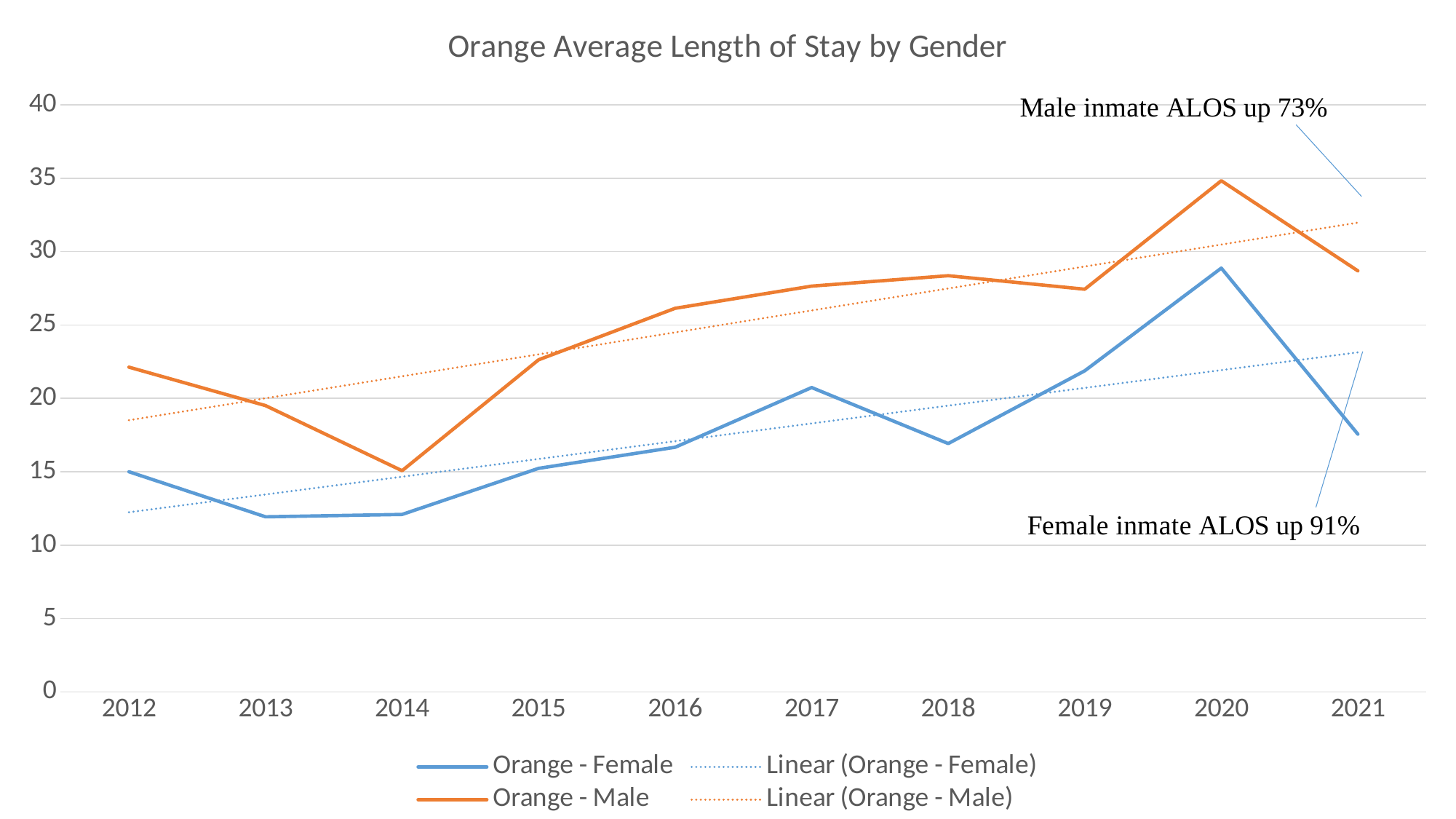
In which year does the Orange - Male series reach its lowest value? 2014 In which year does the Orange - Female series reach its highest value? 2020 What is the title of the chart? Orange Average Length of Stay by Gender Is the value for Orange - Female in 2012 greater or less than 20? less How many series does the legend list? 4 Is the value for Orange - Male in 2020 greater or less than 30? greater In 2021, which series has the higher value, Orange - Male or Orange - Female? Orange - Male How many years are shown on the x axis? 10 Is the value for Orange - Male in 2014 greater or less than 20? less In which year does the Orange - Male series reach its highest value? 2020 What kind of chart is shown on the slide? Line chart According to the annotation on the chart, by what percentage is female inmate ALOS up? 91%